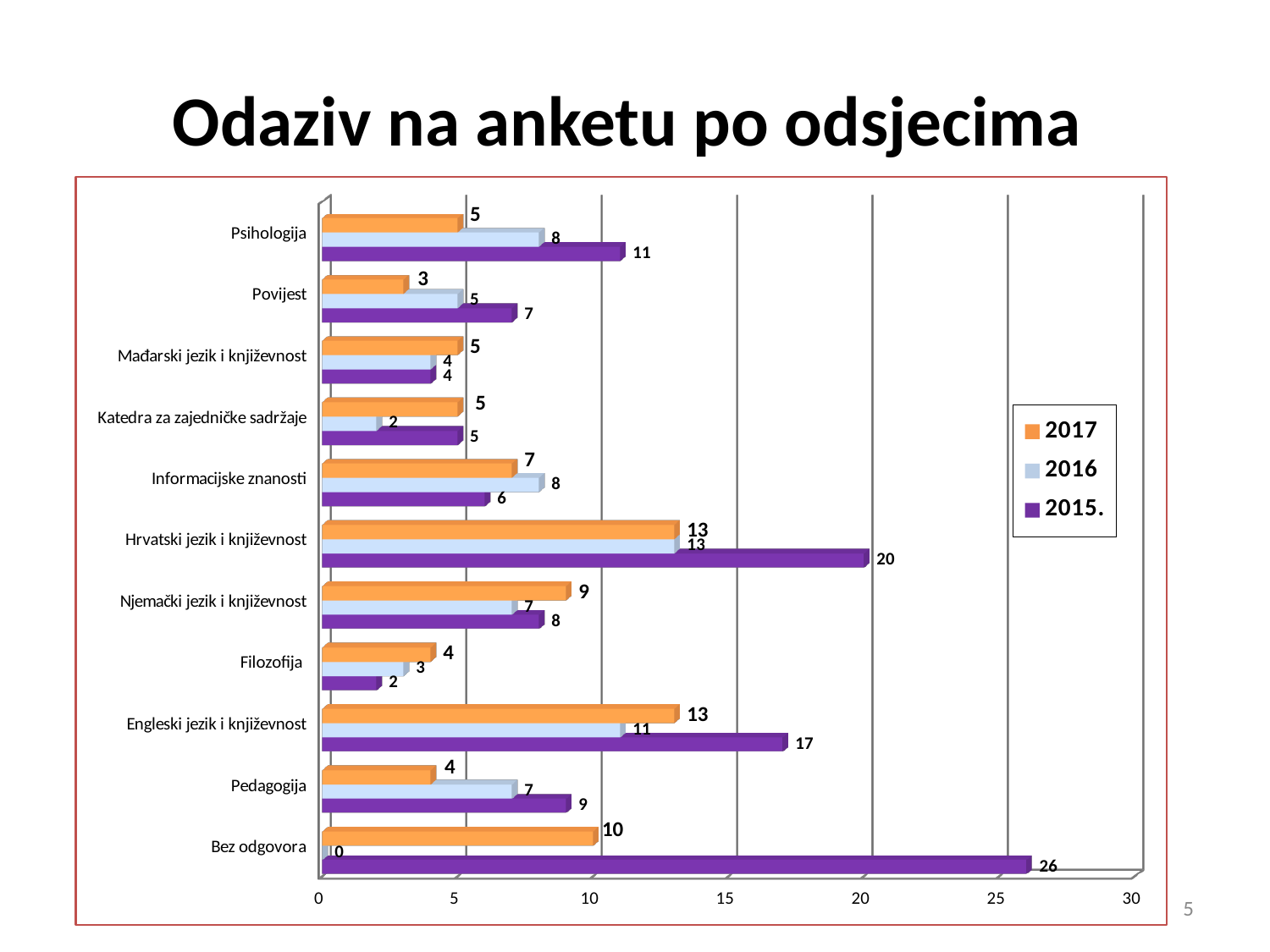
Which is larger for Pedagogija, the 2016 value or the 2017 value? 2016 What is the title of the slide? Odaziv na anketu po odsjecima What is the 2016 value for Katedra za zajedničke sadržaje? 2 What is the difference between the 2015. and 2016 values for Engleski jezik i književnost? 6 What is the 2017 value for Njemački jezik i književnost? 9 What type of chart is shown on the slide? bar chart How many series does the legend list? 3 What is the difference between the 2015. and 2017 values for Hrvatski jezik i književnost? 7 What is the 2015. value for Bez odgovora? 26 Which category has the lowest 2016 value? Bez odgovora How many categories are shown on the chart? 11 Which category has the highest 2015. value? Bez odgovora